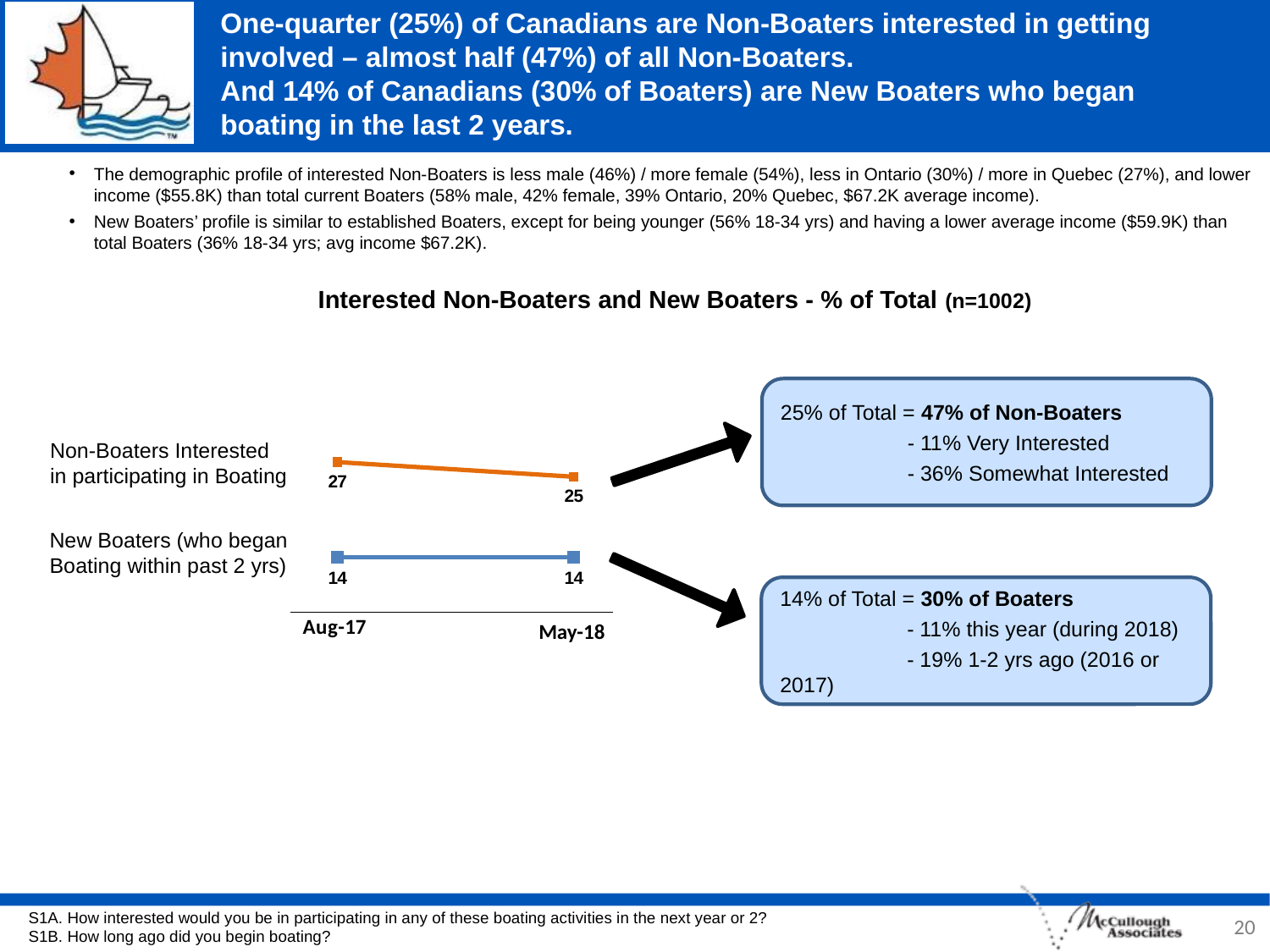
What is the value for Non-Boaters Interested in participating in Boating in May-18? 25 What is the value for New Boaters (who began Boating within past 2 yrs) in May-18? 14 Does the value for Non-Boaters Interested in participating in Boating rise or fall from Aug-17 to May-18? fall Which series has the higher value in Aug-17, Non-Boaters Interested or New Boaters? Non-Boaters Interested in participating in Boating What is the value for New Boaters (who began Boating within past 2 yrs) in Aug-17? 14 What is the difference between the Non-Boaters Interested value and the New Boaters value in May-18? 11 What type of chart is shown on the slide? line chart By how much did the value for Non-Boaters Interested in participating in Boating change from Aug-17 to May-18? 2 How many time points are shown on the x axis of the chart? 2 Does the value for New Boaters (who began Boating within past 2 yrs) rise, fall or stay the same from Aug-17 to May-18? stay the same What is the value for Non-Boaters Interested in participating in Boating in Aug-17? 27 How many series are plotted in the chart? 2